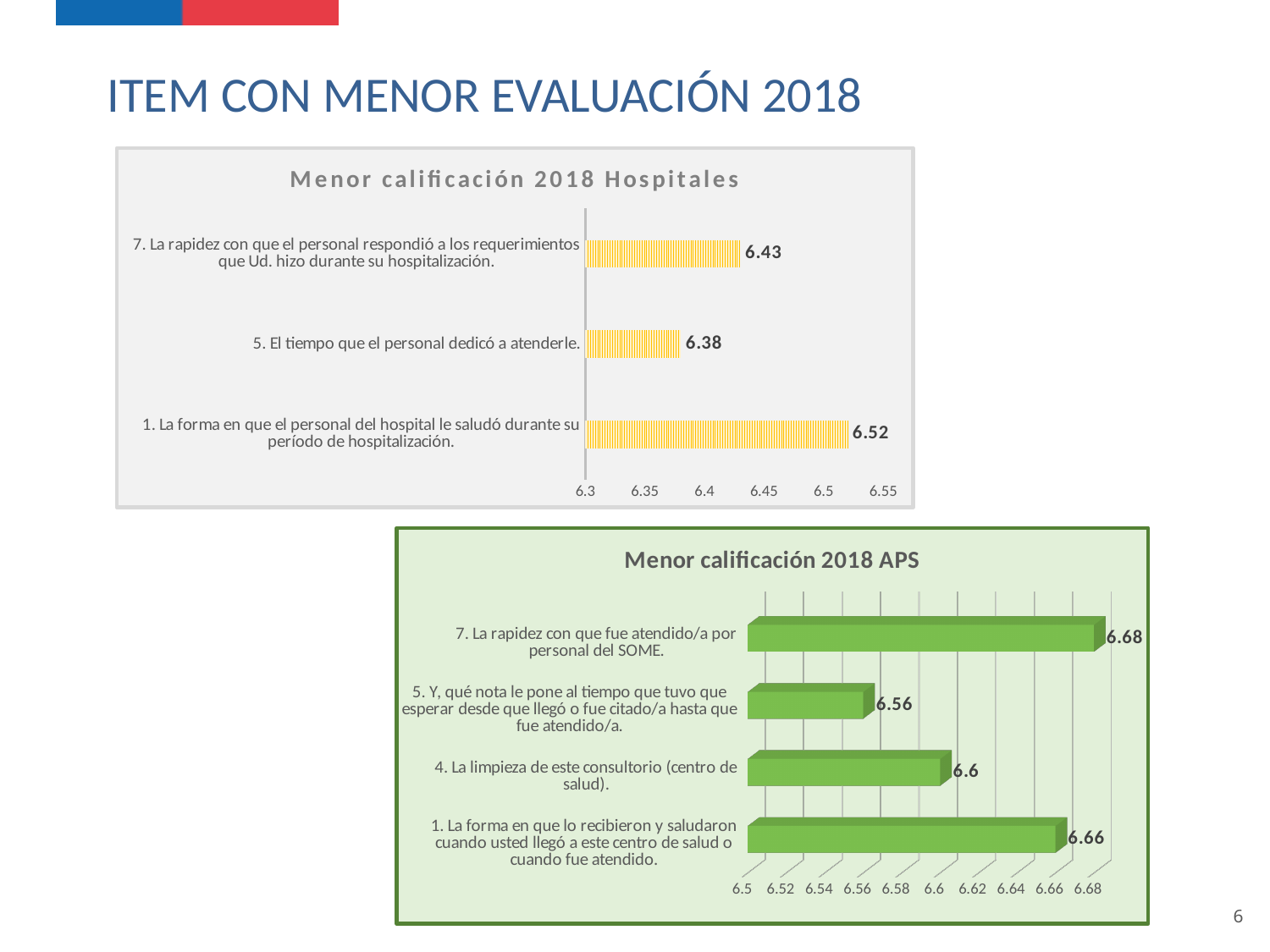
In the 'Menor calificación 2018 Hospitales' chart, is the value for item 7 greater or less than 6.4? greater In the 'Menor calificación 2018 APS' chart, which item has the highest value? 7. La rapidez con que fue atendido/a por personal del SOME. How many bars are shown in the 'Menor calificación 2018 Hospitales' chart? 3 In the 'Menor calificación 2018 Hospitales' chart, which item has the lowest value? 5. El tiempo que el personal dedicó a atenderle. How many bars are shown in the 'Menor calificación 2018 APS' chart? 4 In the 'Menor calificación 2018 APS' chart, what is the difference between the values for item 7 and item 1? 0.02 In the 'Menor calificación 2018 Hospitales' chart, which item has the highest value? 1. La forma en que el personal del hospital le saludó durante su período de hospitalización. In the 'Menor calificación 2018 APS' chart, what is the value for '4. La limpieza de este consultorio (centro de salud).'? 6.6 In the 'Menor calificación 2018 APS' chart, which item has the lowest value? 5. Y, qué nota le pone al tiempo que tuvo que esperar desde que llegó o fue citado/a hasta que fue atendido/a. What type of chart is 'Menor calificación 2018 Hospitales'? Bar chart In the 'Menor calificación 2018 Hospitales' chart, what is the value for '5. El tiempo que el personal dedicó a atenderle.'? 6.38 In the 'Menor calificación 2018 Hospitales' chart, what is the difference between the values for item 1 and item 5? 0.14